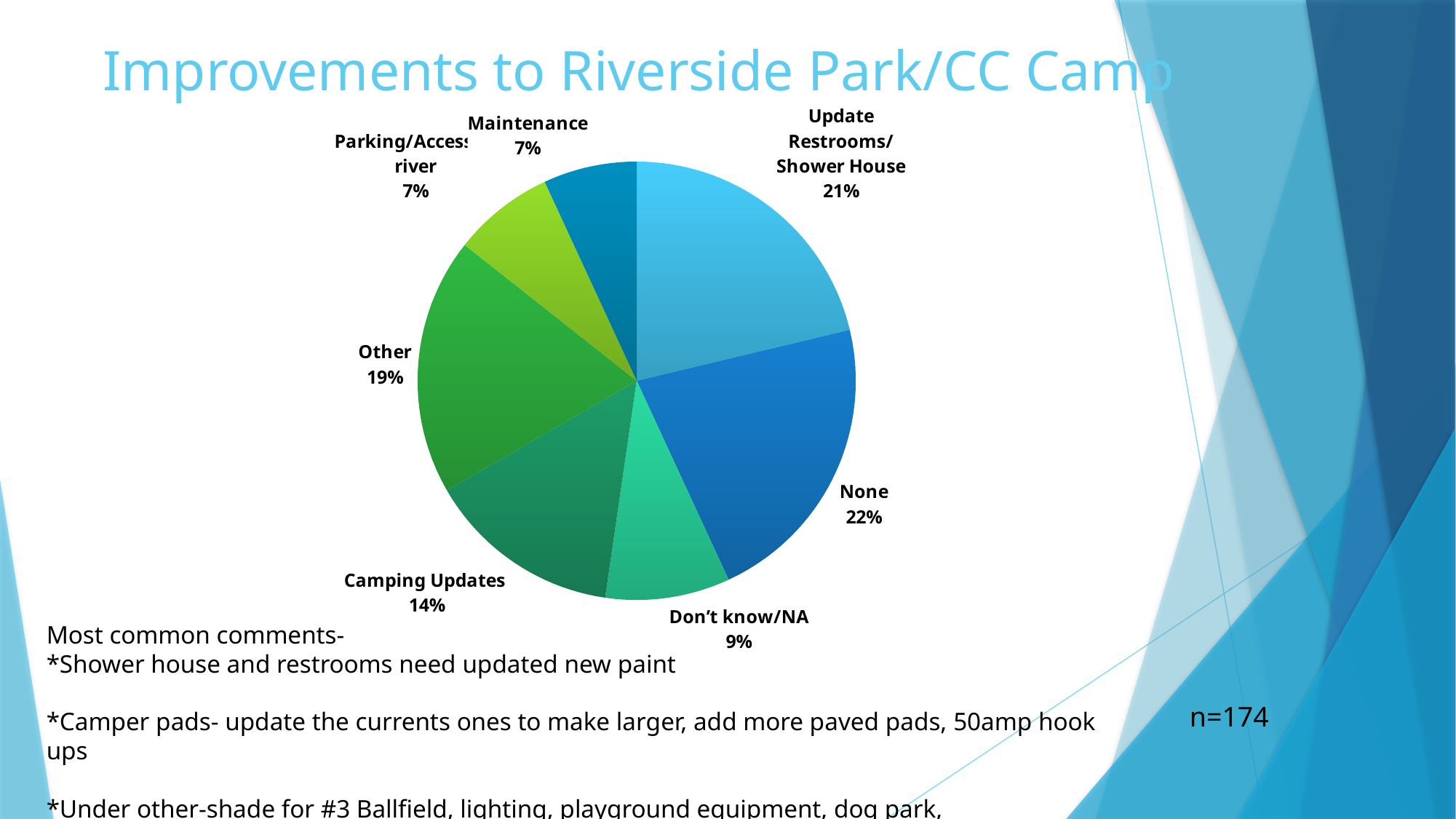
What kind of chart is shown on the slide? pie chart What is the value for the "Other" slice? 19% How many categories (slices) does the pie chart have? 7 What percentage is shown for "Don't know/NA"? 9% What is the value shown for "Camping Updates"? 14% Which category has the largest share of the pie? None What is the difference between the "Other" share and the "Don't know/NA" share? 10% What is the difference in percentage points between "None" and "Camping Updates"? 8% Which is larger, the share for "Other" or the share for "Camping Updates"? Other What is the title of the chart? Improvements to Riverside Park/CC Camp What percentage of the pie is labelled "None"? 22% What share does "Update Restrooms/Shower House" have in the pie chart? 21%